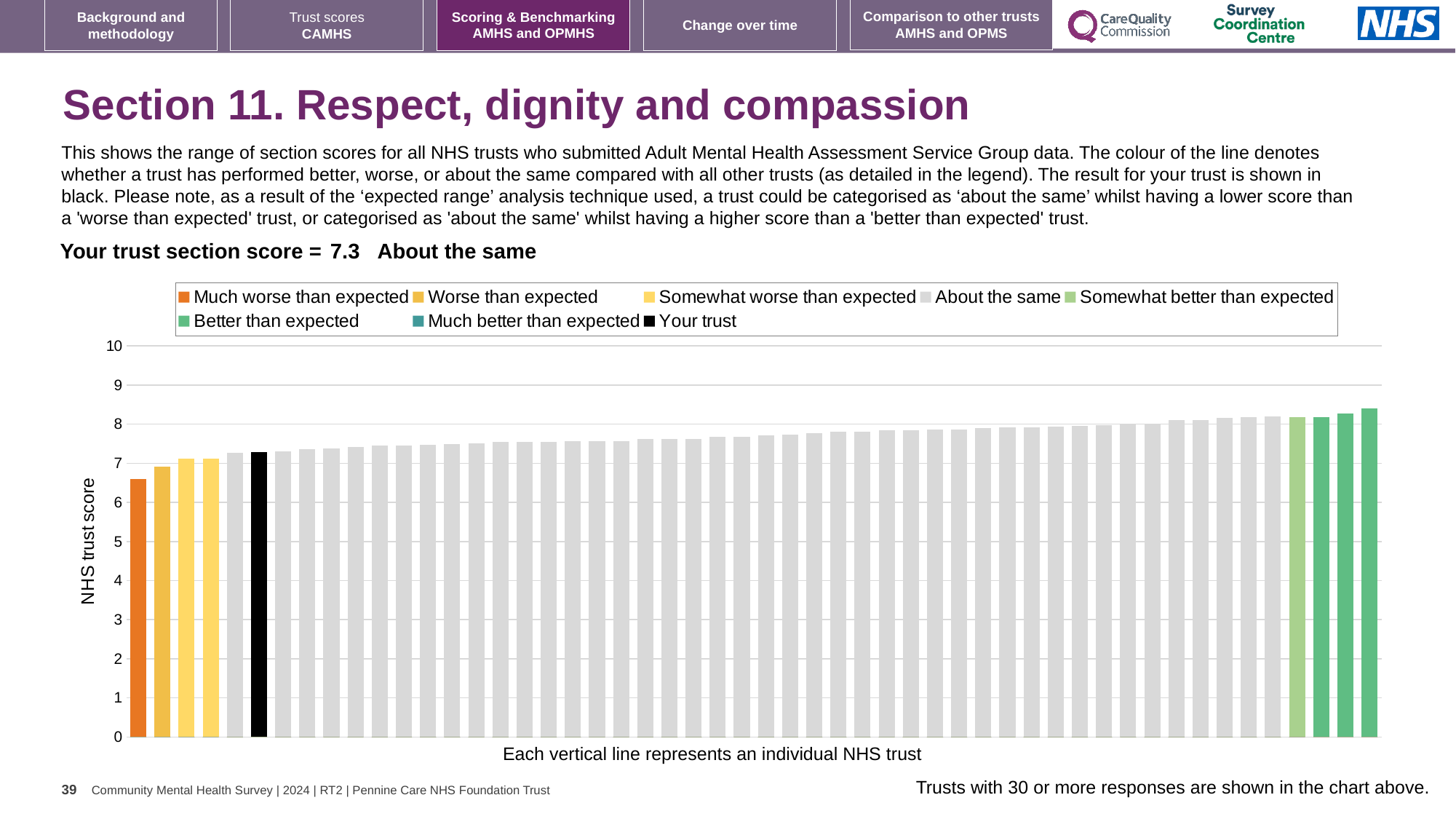
What is the label on the vertical axis of the chart? NHS trust score What kind of chart is shown on the slide? bar chart Is the value of the highest bar (the rightmost bar) greater or less than 8? greater Which legend category does the lowest bar in the chart belong to? Much worse than expected Is the value of the highest bar (the rightmost bar) greater or less than 9? less How many entries does the chart legend list? 8 Is the value for your trust greater or less than 7? greater Which category is your trust's section score placed in? About the same Do the bar values rise or fall from left to right along the x axis? rise Is the leftmost bar larger or smaller than the bar for your trust? smaller What is the section score for your trust shown on the slide? 7.3